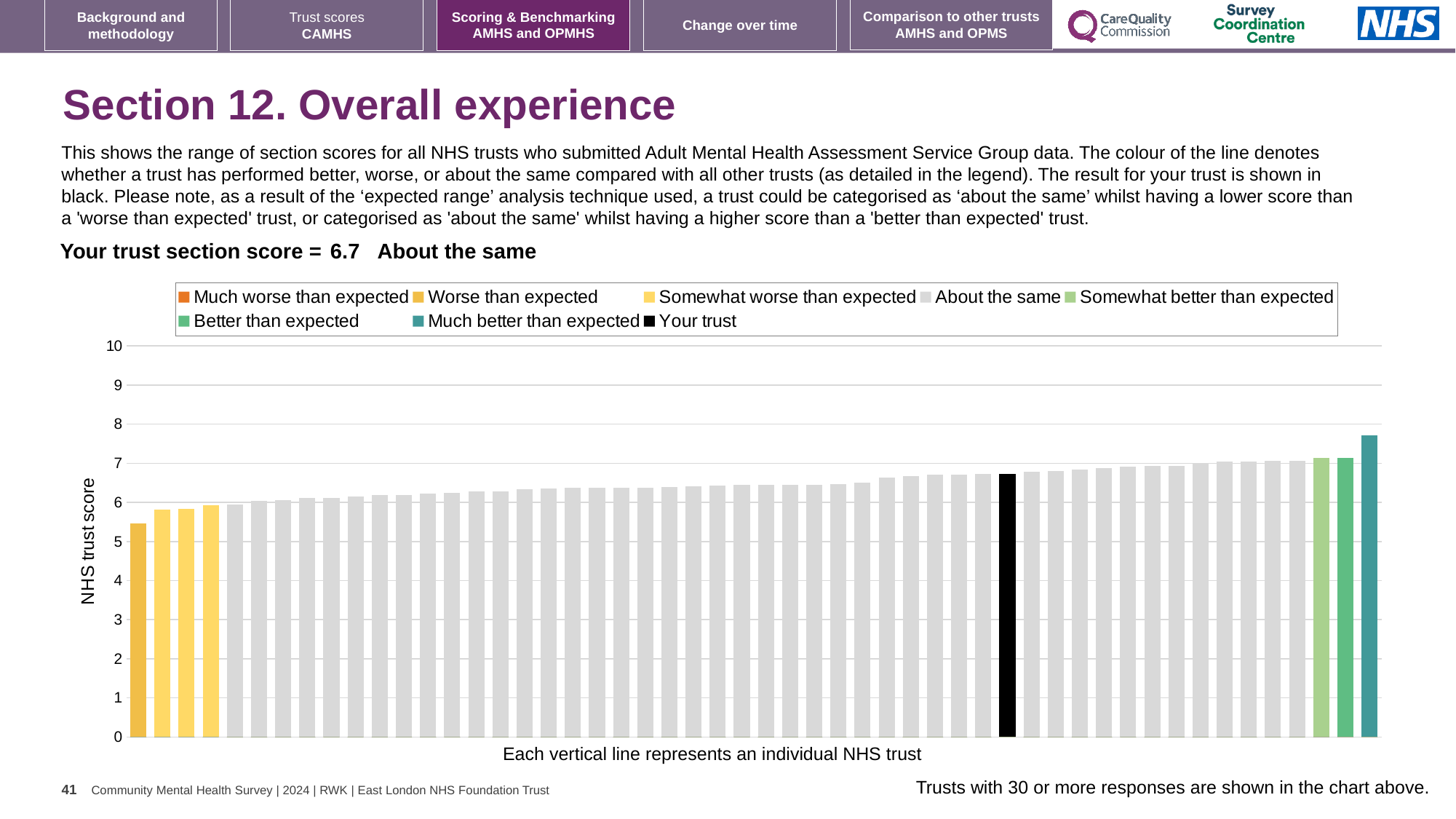
What is the section score for 'Your trust' shown on the slide? 6.7 Is the value of the leftmost (shortest) bar greater or less than 6? less What kind of chart is shown on the slide? bar chart Is the value of the leftmost (shortest) bar greater or less than 5? greater What is the label on the vertical axis of the chart? NHS trust score Do the bar values rise or fall from left to right across the chart? rise How many black 'Your trust' bars are shown in the chart? 1 Is the value of the black 'Your trust' bar greater or less than 7? less How many entries does the chart legend list? 8 Which legend category does the tallest bar in the chart belong to? Much better than expected Which is larger: the black 'Your trust' bar or the leftmost bar? Your trust